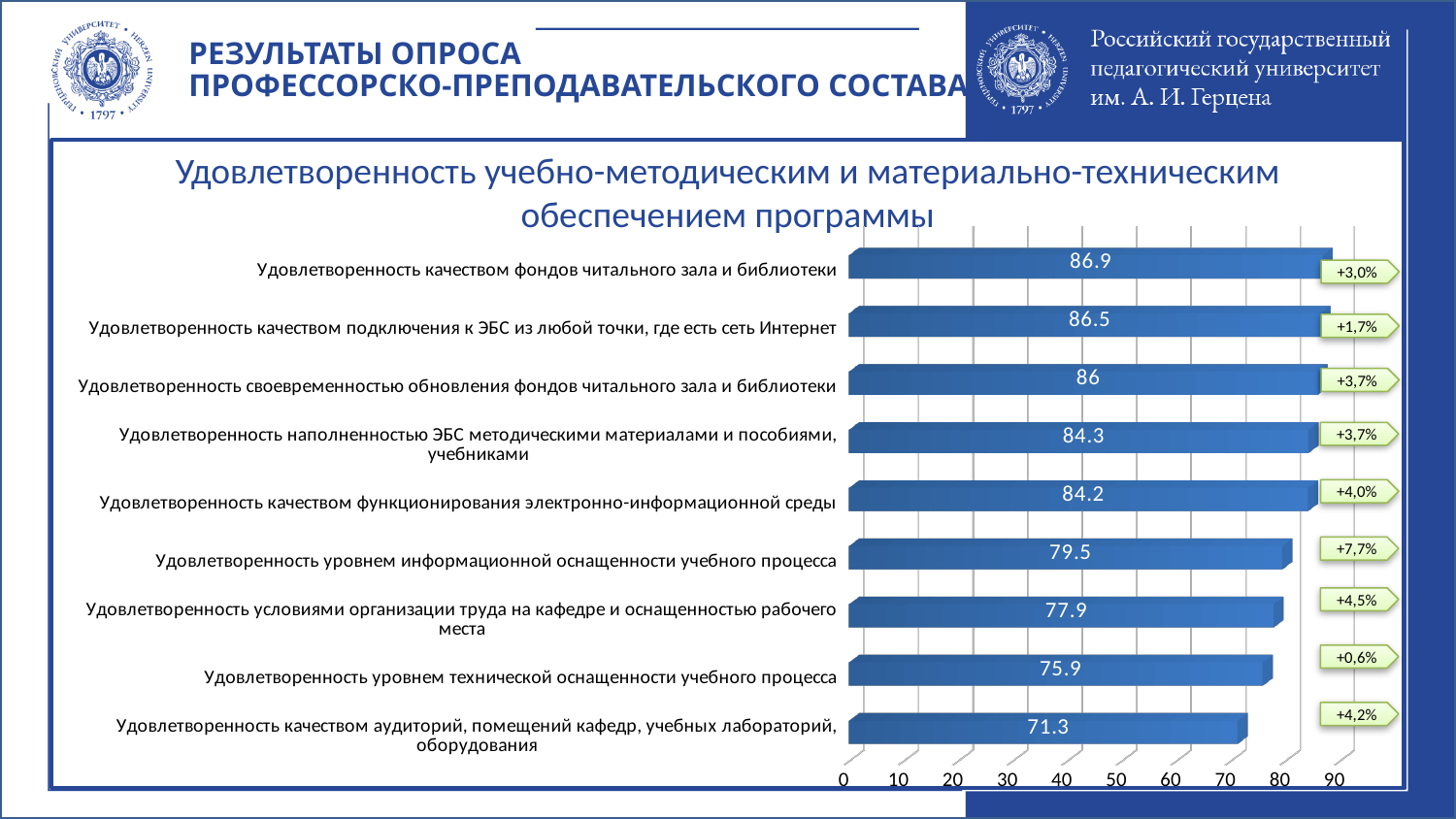
How many categories are shown in the chart? 9 What is the difference between the highest value (86.9) and the lowest value (71.3)? 15.6 What is the value for «Удовлетворенность качеством аудиторий, помещений кафедр, учебных лабораторий, оборудования»? 71.3 Do the values rise or fall going from the top bar to the bottom bar? fall What is the value for «Удовлетворенность качеством фондов читального зала и библиотеки»? 86.9 Is the value for «Удовлетворенность условиями организации труда на кафедре и оснащенностью рабочего места» greater or less than 80? less Which category has the highest value? Удовлетворенность качеством фондов читального зала и библиотеки What is the title of the chart? Удовлетворенность учебно-методическим и материально-техническим обеспечением программы What is the value for «Удовлетворенность уровнем информационной оснащенности учебного процесса»? 79.5 Which category has the lowest value? Удовлетворенность качеством аудиторий, помещений кафедр, учебных лабораторий, оборудования What kind of chart is shown on the slide? bar chart Which is larger: the value for «Удовлетворенность уровнем информационной оснащенности учебного процесса» or for «Удовлетворенность уровнем технической оснащенности учебного процесса»? Удовлетворенность уровнем информационной оснащенности учебного процесса